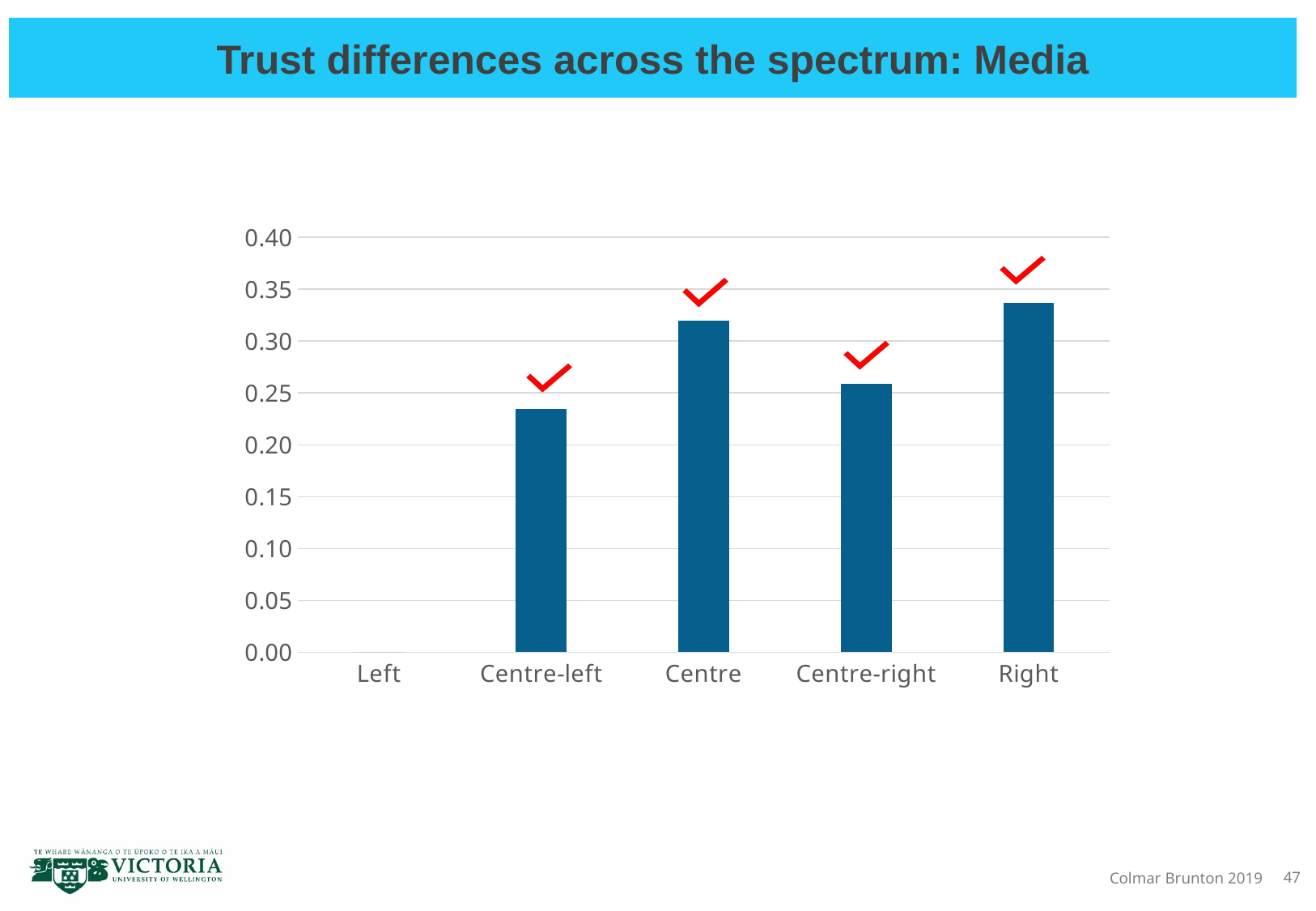
Is the value for Centre greater or less than 0.30? greater What is the title of the slide? Trust differences across the spectrum: Media Which is larger, the value for Centre or the value for Centre-right? Centre Is the value for Right greater or less than 0.30? greater Is the value for Centre-right greater or less than 0.25? greater What kind of chart is shown on the slide? bar chart Which is larger, the value for Centre-left or the value for Centre-right? Centre-right Which category has the tallest bar? Right Which category has no visible bar? Left How many categories are shown on the x axis? 5 How many red check marks are shown above the bars? 4